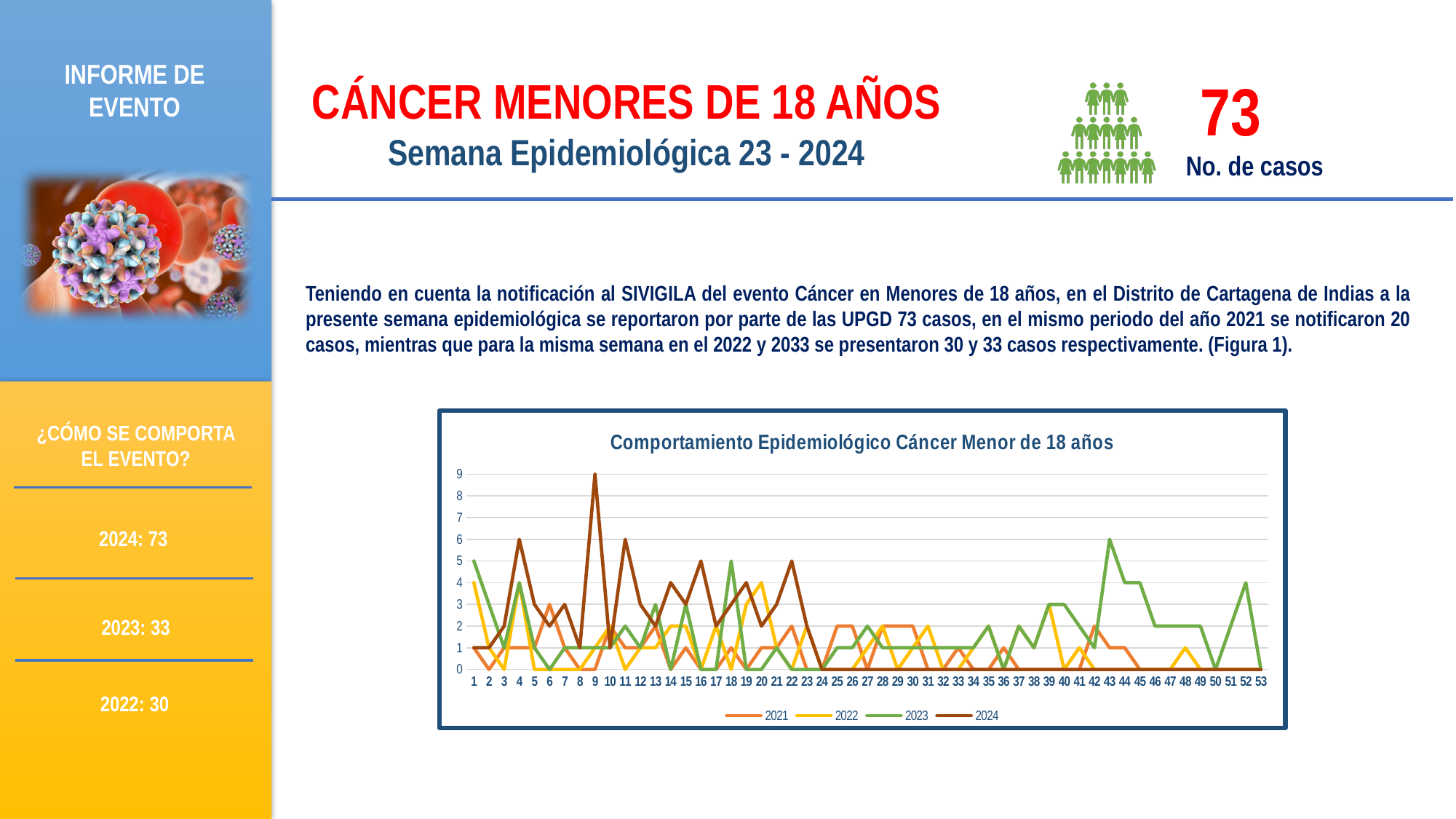
How many weeks are shown along the x axis of the chart? 53 What is the title of the chart? Comportamiento Epidemiológico Cáncer Menor de 18 años How many series does the legend of the chart list? 4 Is the value of the 2024 series in week 9 greater or less than 8? greater In week 9, which series has the larger value, 2024 or 2021? 2024 Is the value of the 2023 series in week 43 greater or less than 5? greater What kind of chart is shown on the slide? line chart In which week does the 2024 series reach its highest value? 9 In which week does the 2023 series reach its highest value? 43 Does the 2024 series rise or fall from week 22 to week 24? fall What is the value of the 2024 series in week 9? 9 Which series is drawn in dark brown in the chart? 2024